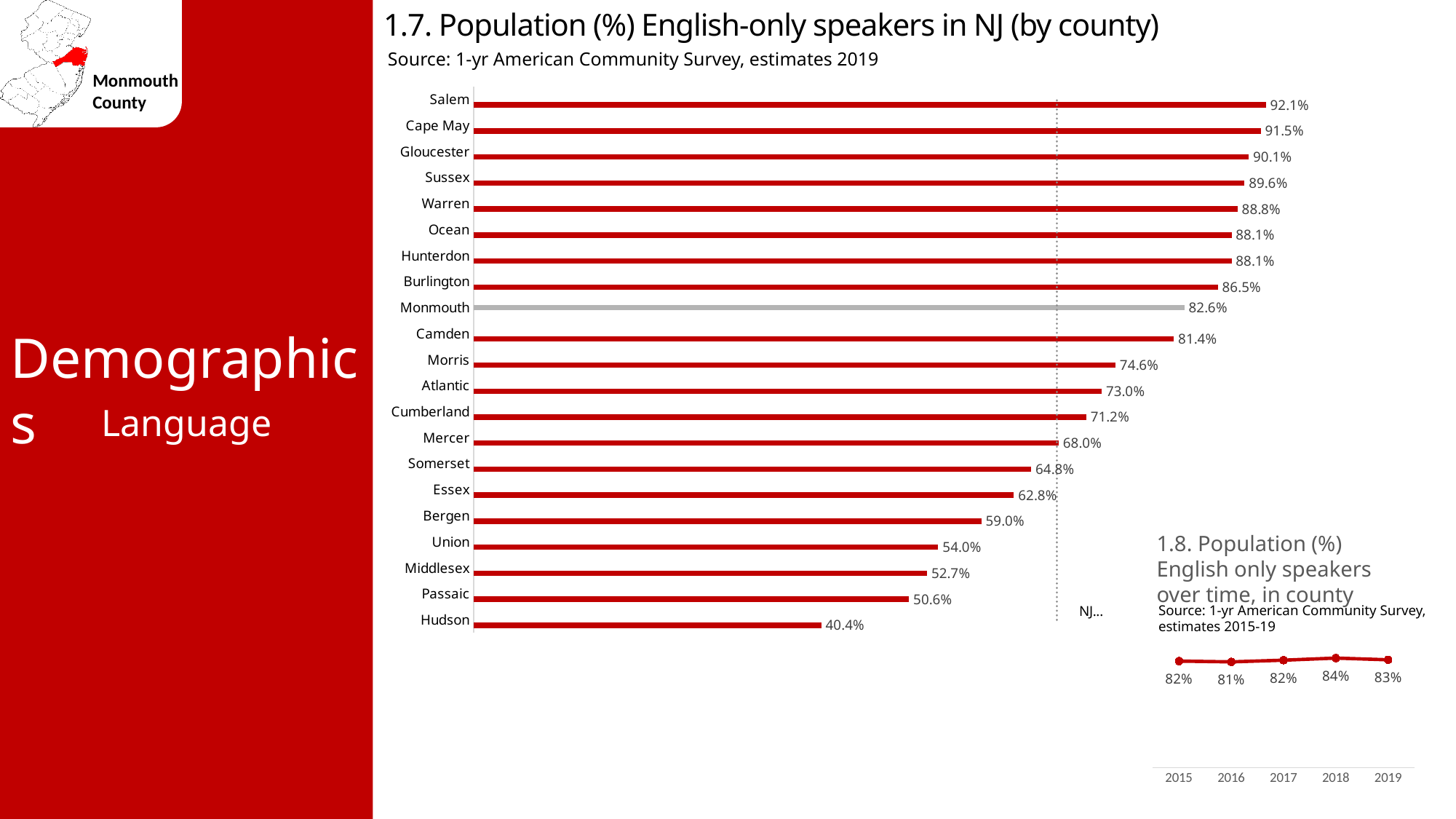
In chart 1.8 (English only speakers over time, in county), how many years are plotted? 5 In chart 1.7 (English-only speakers by county), which county has the highest value? Salem What kind of chart is chart 1.8 (English only speakers over time, in county)? Line chart In chart 1.7 (English-only speakers by county), what is the value for Monmouth? 82.6% In chart 1.8 (English only speakers over time, in county), which year has the lowest value? 2016 In chart 1.7 (English-only speakers by county), what is the value for Hudson? 40.4% In chart 1.7 (English-only speakers by county), what is the difference between Salem and Hudson? 51.7% In chart 1.7 (English-only speakers by county), which is larger, the value for Camden or the value for Morris? Camden What kind of chart is chart 1.7 (English-only speakers by county)? Bar chart In chart 1.8 (English only speakers over time, in county), what is the value for 2018? 84% In chart 1.7 (English-only speakers by county), how many counties are plotted? 21 In chart 1.7 (English-only speakers by county), which county has the lowest value? Hudson